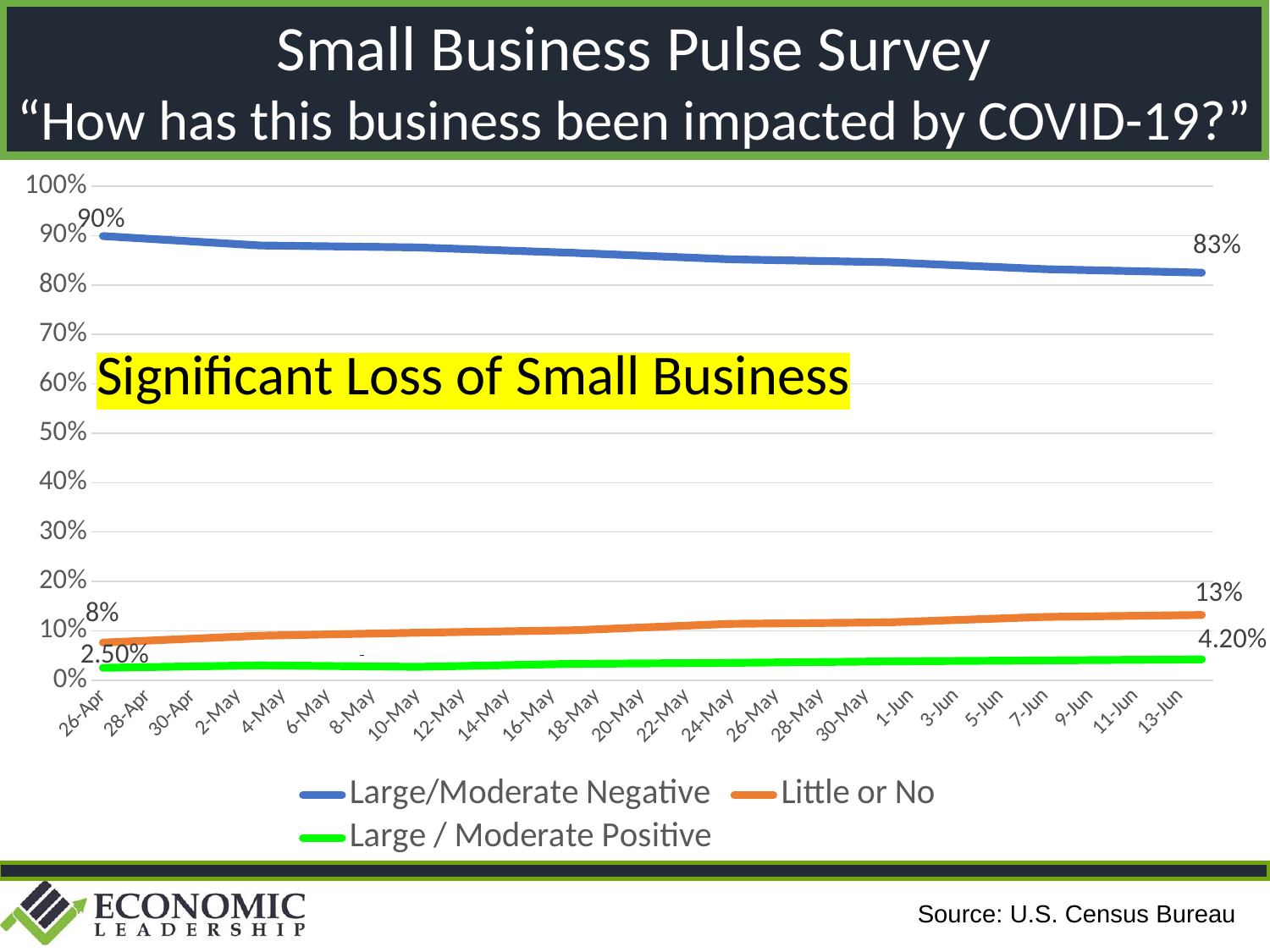
Which series has the highest values throughout the chart? Large/Moderate Negative How many series does the legend list? 3 What is the value of the Large / Moderate Positive series on 13-Jun? 4.20% What is the value of the Large/Moderate Negative series on 26-Apr? 90% Does the Large/Moderate Negative series rise or fall from 26-Apr to 13-Jun? Fall What kind of chart is shown on the slide? Line chart On 13-Jun, which is larger: Little or No or Large / Moderate Positive? Little or No What is the value of the Little or No series on 26-Apr? 8% By how many percentage points did the Little or No series rise from 26-Apr to 13-Jun? 5 percentage points What is the value of the Large/Moderate Negative series on 13-Jun? 83% What is the value of the Little or No series on 13-Jun? 13% By how many percentage points did the Large/Moderate Negative series fall from 26-Apr to 13-Jun? 7 percentage points